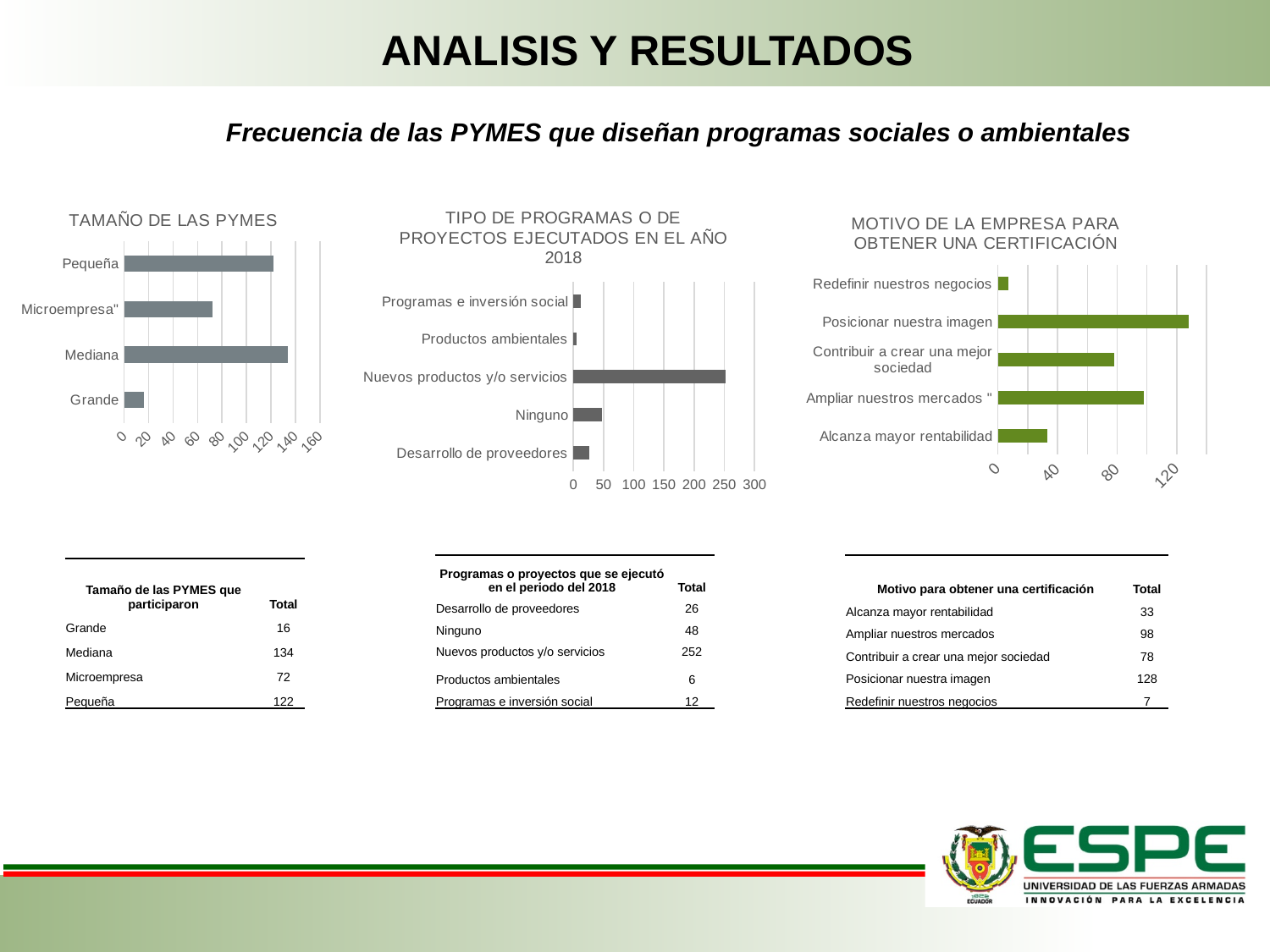
In the chart titled TAMAÑO DE LAS PYMES, is the value for Microempresa greater or less than 80? less What type of chart is the one titled MOTIVO DE LA EMPRESA PARA OBTENER UNA CERTIFICACIÓN? bar chart In the chart titled TAMAÑO DE LAS PYMES, how many categories are shown? 4 In the chart titled TAMAÑO DE LAS PYMES, which category has the highest value? Mediana According to the table under the MOTIVO chart, what is the difference between Posicionar nuestra imagen and Alcanza mayor rentabilidad? 95 According to the table under the TAMAÑO DE LAS PYMES chart, what is the total for Pequeña? 122 In the chart titled TIPO DE PROGRAMAS O PROYECTOS EJECUTADOS EN EL AÑO 2018, is the value for Nuevos productos y/o servicios greater or less than 200? greater In the chart titled MOTIVO DE LA EMPRESA PARA OBTENER UNA CERTIFICACIÓN, which is larger: Ampliar nuestros mercados or Contribuir a crear una mejor sociedad? Ampliar nuestros mercados In the chart titled MOTIVO DE LA EMPRESA PARA OBTENER UNA CERTIFICACIÓN, which category has the lowest value? Redefinir nuestros negocios According to the table under the TIPO DE PROGRAMAS chart, what is the total for Ninguno? 48 In the chart titled TIPO DE PROGRAMAS O PROYECTOS EJECUTADOS EN EL AÑO 2018, which category has the highest value? Nuevos productos y/o servicios In the chart titled TAMAÑO DE LAS PYMES, which category has the lowest value? Grande